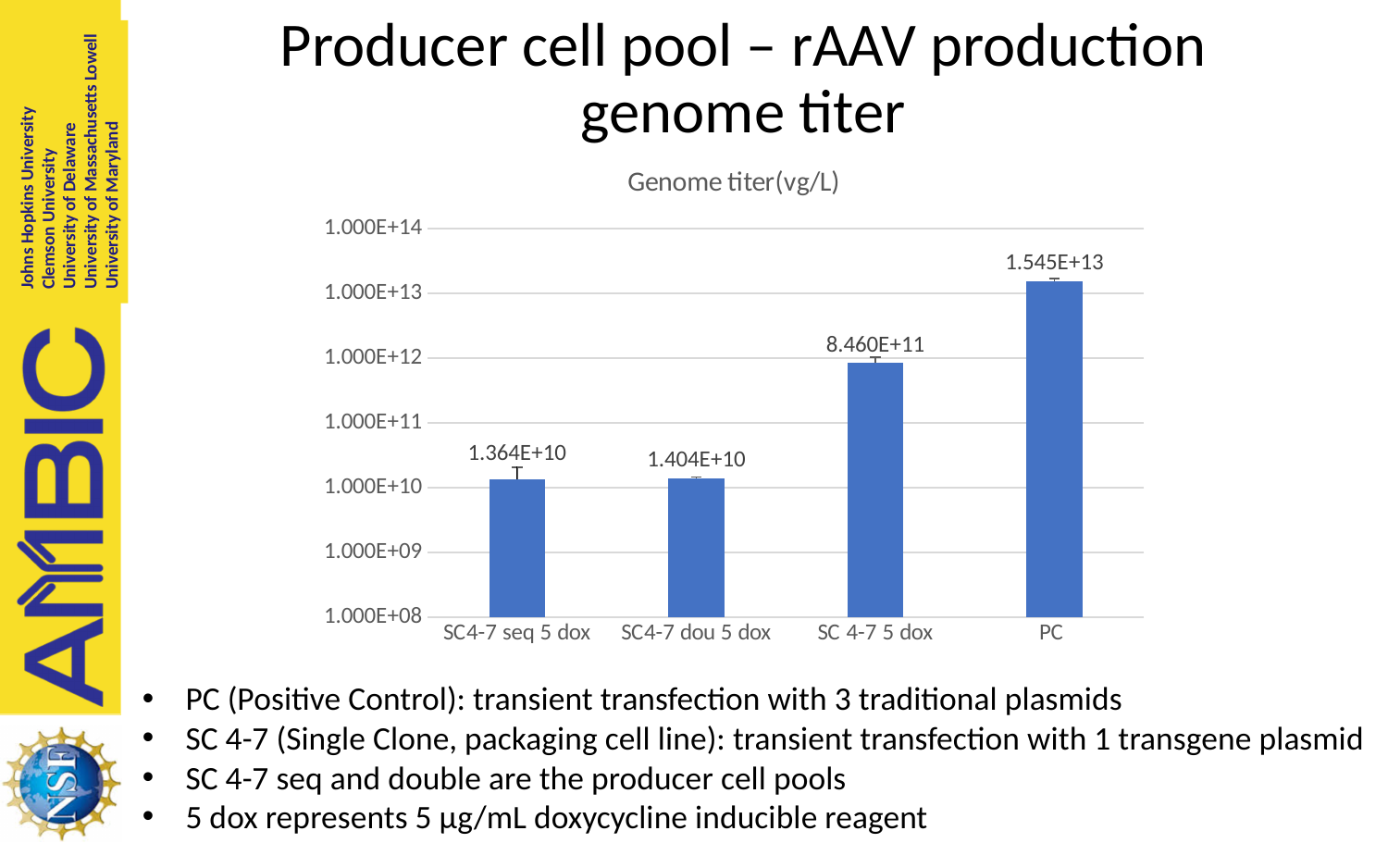
What is the title of the chart? Genome titer(vg/L) Which category has the highest genome titer? PC Do the genome titer values rise or fall from left to right along the x axis? Rise What is the genome titer value for SC4-7 seq 5 dox? 1.364E+10 What type of chart is shown on the slide? Bar chart Which category has the lowest genome titer? SC4-7 seq 5 dox What is the genome titer value for SC 4-7 5 dox? 8.460E+11 Which has a larger genome titer, SC 4-7 5 dox or PC? PC Is the value for SC 4-7 5 dox greater or less than 1.000E+12? less What is the genome titer value for PC? 1.545E+13 How many categories are plotted on the x axis of the chart? 4 What is the genome titer value for SC4-7 dou 5 dox? 1.404E+10